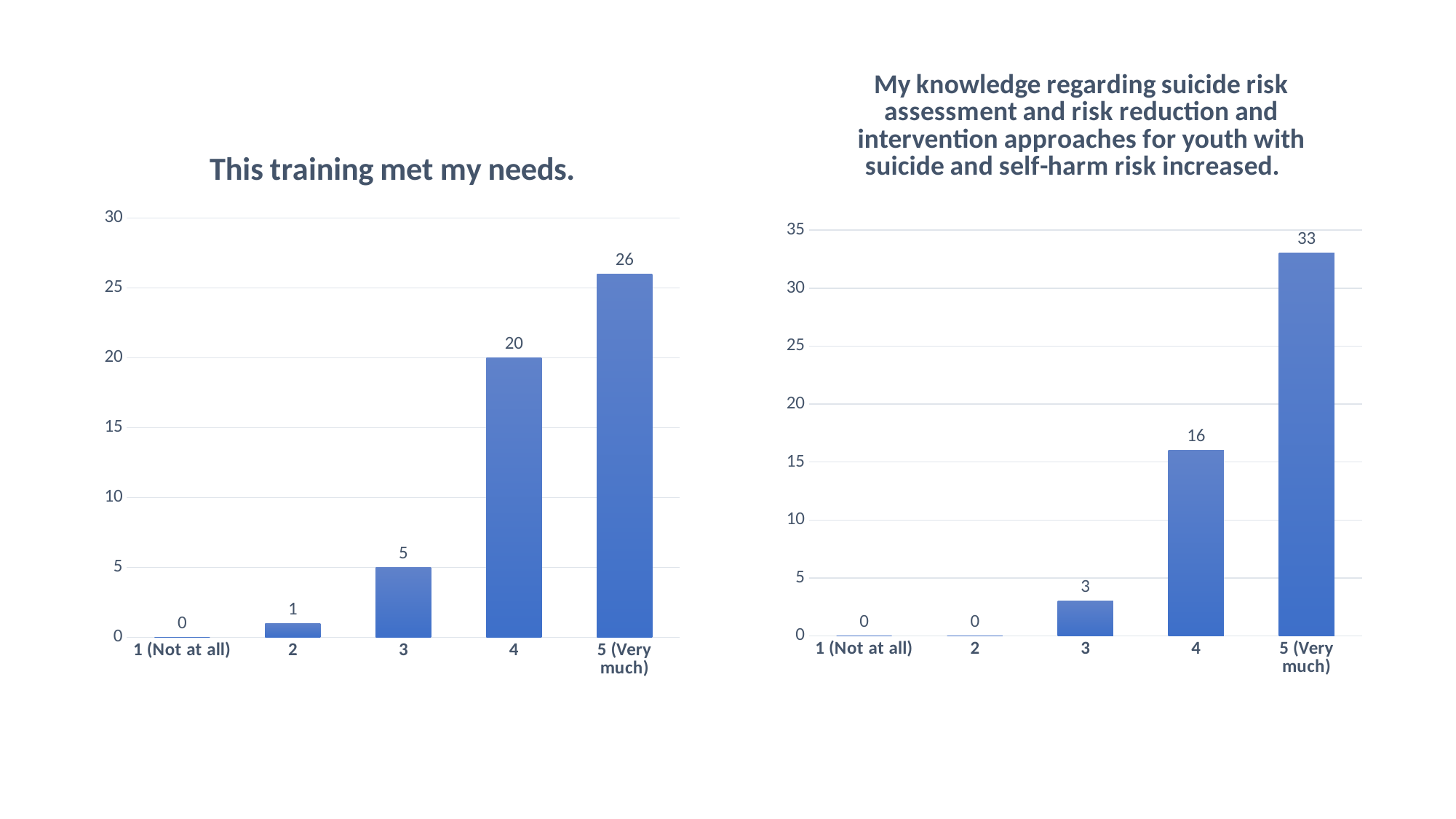
In the chart on the right about knowledge regarding suicide risk assessment, what is the value for "5 (Very much)"? 33 In the chart titled "This training met my needs.", how many rating categories are shown on the x axis? 5 In the chart on the right about knowledge regarding suicide risk assessment, what is the value for rating 3? 3 In the chart titled "This training met my needs.", which rating has the highest value? 5 (Very much) In the chart titled "This training met my needs.", what is the value for rating 4? 20 In the chart on the right about knowledge regarding suicide risk assessment, what is the difference between the values for rating 5 (Very much) and rating 4? 17 In the chart titled "This training met my needs.", what is the difference between the values for rating 5 (Very much) and rating 4? 6 In the chart titled "This training met my needs.", what is the value for "5 (Very much)"? 26 In the chart titled "This training met my needs.", do the values rise or fall from rating 1 to rating 5? rise In the chart on the right about knowledge regarding suicide risk assessment, which rating has the lowest value? 1 (Not at all) and 2 (both 0) In the chart on the right about knowledge regarding suicide risk assessment, is the value for rating 4 larger or smaller than the value for rating 3? larger What kind of chart is used in "This training met my needs."? bar chart